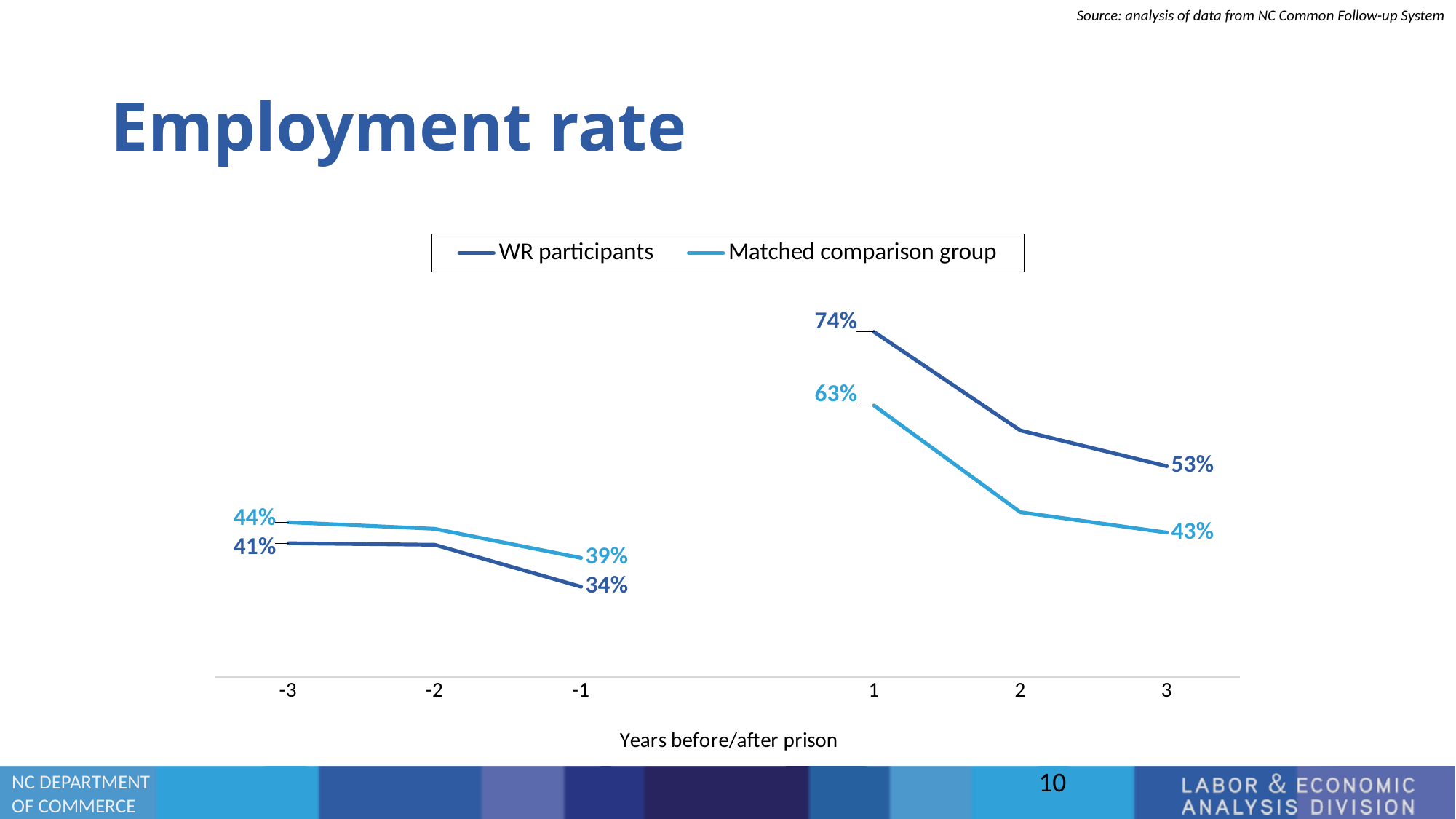
What is the employment rate for the Matched comparison group at year -3 before prison? 44% Do the employment rates for WR participants rise or fall from year 1 to year 3 after prison? fall What is the employment rate for the Matched comparison group at year 3 after prison? 43% At which year is the employment rate for WR participants highest? 1 What is the label of the x axis? Years before/after prison How many series does the legend list? 2 At year -3, which series has the higher employment rate, WR participants or Matched comparison group? Matched comparison group What is the difference between the WR participants and Matched comparison group employment rates at year 1? 11% What is the employment rate for WR participants at year -1 before prison? 34% What kind of chart is shown on the slide? line chart At which year is the employment rate for WR participants lowest? -1 What is the employment rate for WR participants at year 1 after prison? 74%